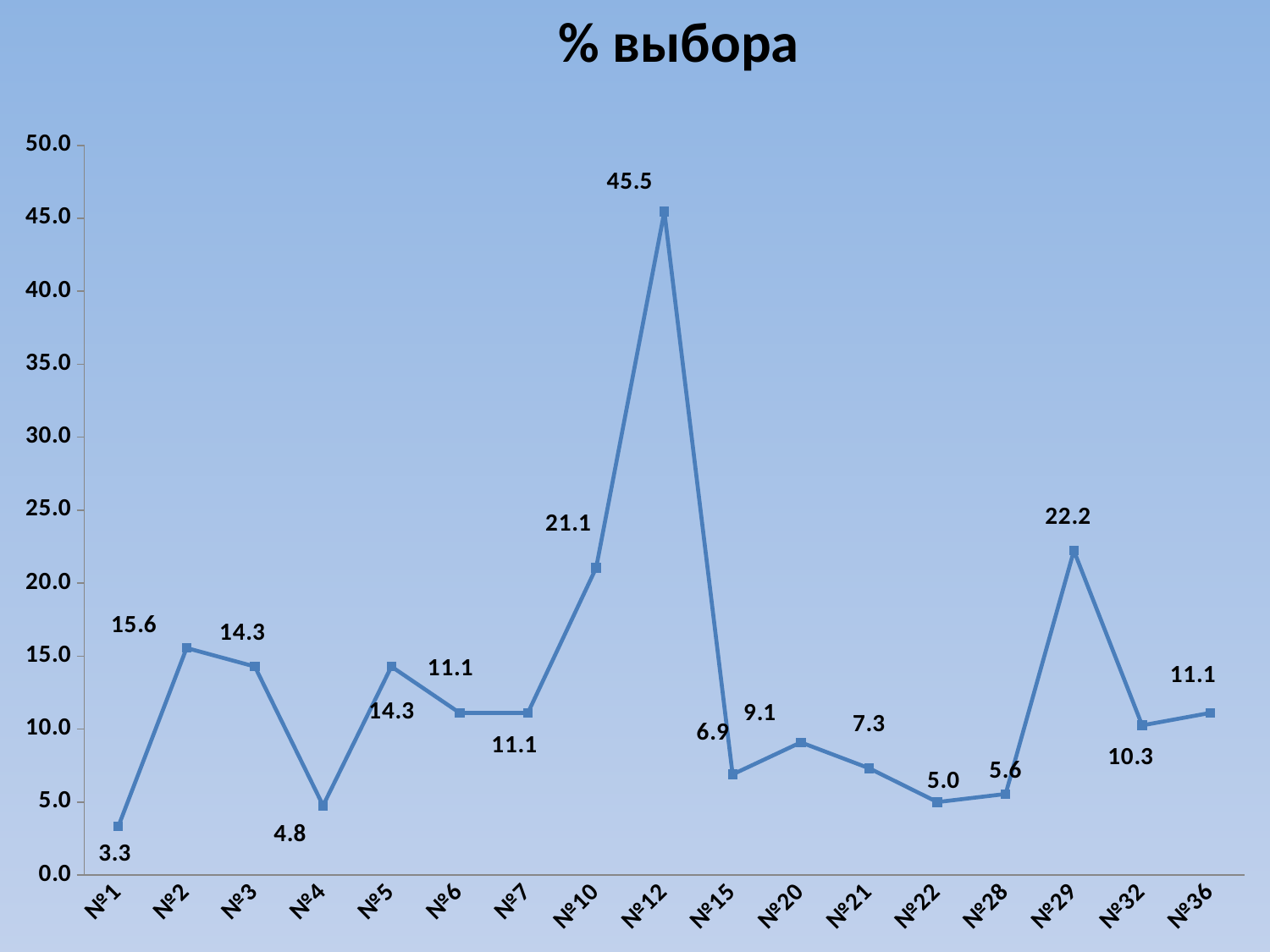
What is the value for №29? 22.2 Is the value for №29 greater or less than 20.0? greater Which category has the highest value? №12 What is the value for №12? 45.5 Which is larger, the value for №2 or the value for №20? №2 What is the value for №32? 10.3 Which category has the lowest value? №1 How many categories are shown on the x axis? 17 What is the difference between the values for №12 and №10? 24.4 What is the title of the chart? % выбора What kind of chart is this? Line chart What is the value for №4? 4.8